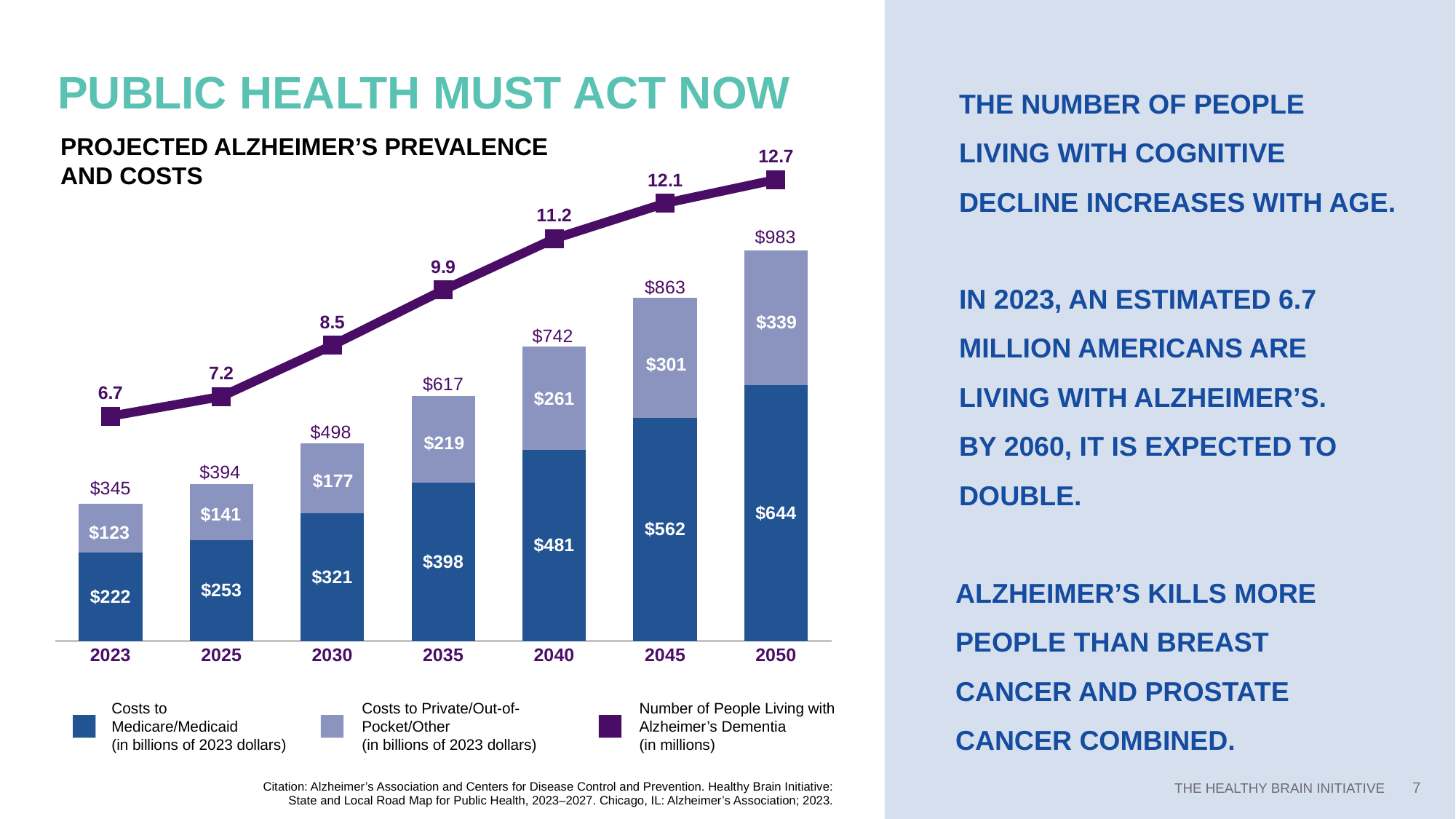
What is the number of people living with Alzheimer's dementia (in millions) in 2035? 9.9 What is the cost to Private/Out-of-Pocket/Other in 2025? $141 How many series does the legend list? 3 What is the title of the chart? Projected Alzheimer's Prevalence and Costs What is the projected cost to Medicare/Medicaid in 2040? $481 Which year has the highest number of people living with Alzheimer's dementia? 2050 Which is larger: the cost to Private/Out-of-Pocket/Other in 2045 or the cost to Medicare/Medicaid in 2030? Cost to Medicare/Medicaid in 2030 What is the difference between the cost to Medicare/Medicaid in 2050 and in 2023? $422 What is the total projected cost shown above the stacked bar for 2050? $983 How many years are shown on the x axis of the chart? 7 Which year has the lowest cost to Medicare/Medicaid? 2023 Does the number of people living with Alzheimer's dementia rise or fall from 2023 to 2050? Rise